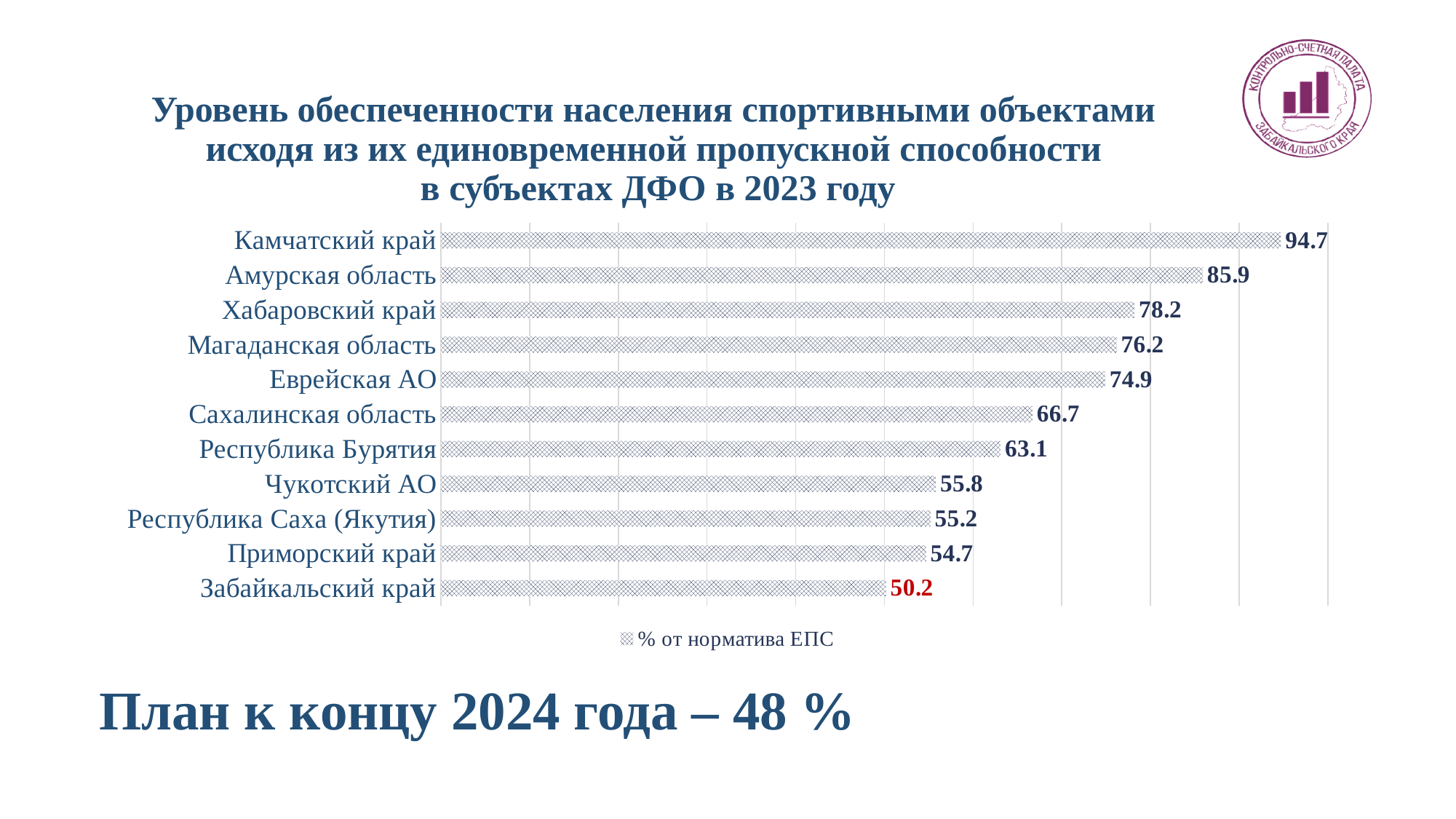
What is the difference between the values for Амурская область and Хабаровский край? 7.7 What is the value for Камчатский край? 94.7 What is the value for Забайкальский край? 50.2 Which region has the highest value? Камчатский край Which region has the lowest value? Забайкальский край What is the difference between the values for Камчатский край and Забайкальский край? 44.5 What is the legend entry of the chart? % от норматива ЕПС How many regions are shown in the chart? 11 What is the value for Сахалинская область? 66.7 What kind of chart is shown on the slide? Bar chart Which is larger, the value for Республика Бурятия or the value for Чукотский АО? Республика Бурятия How many series does the legend list? 1